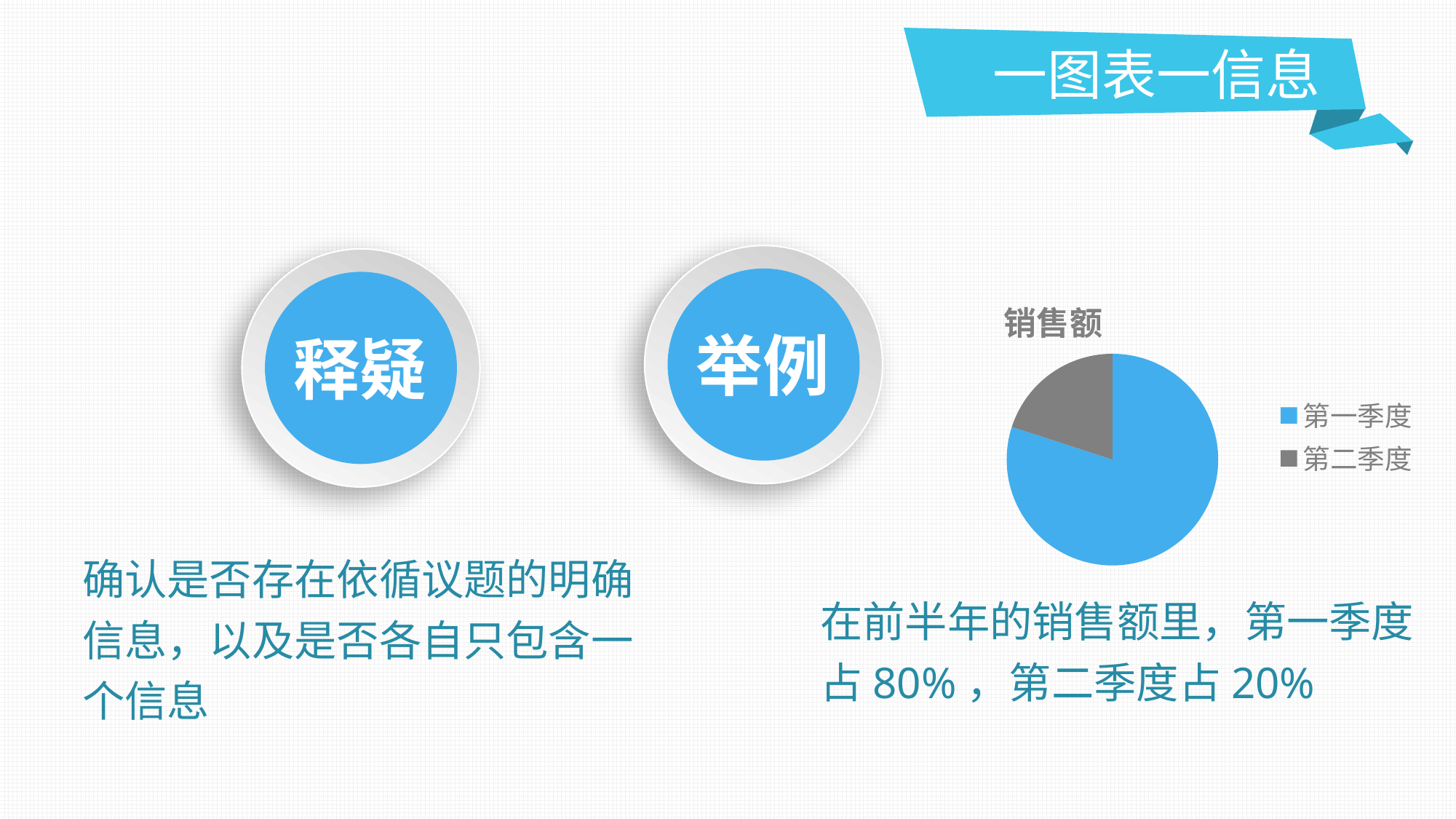
Which category has the smallest slice of the pie? 第二季度 What kind of chart is shown on the slide? Pie chart Which category has the largest slice of the pie? 第一季度 What share of the pie does 第二季度 represent, according to the slide? 20% What colour is the 第二季度 slice in the pie chart? Gray How many entries does the chart legend list? 2 Which slice is larger, 第一季度 or 第二季度? 第一季度 What is the title of the chart? 销售额 How many slices does the pie chart have? 2 What share of the pie does 第一季度 represent, according to the slide? 80%